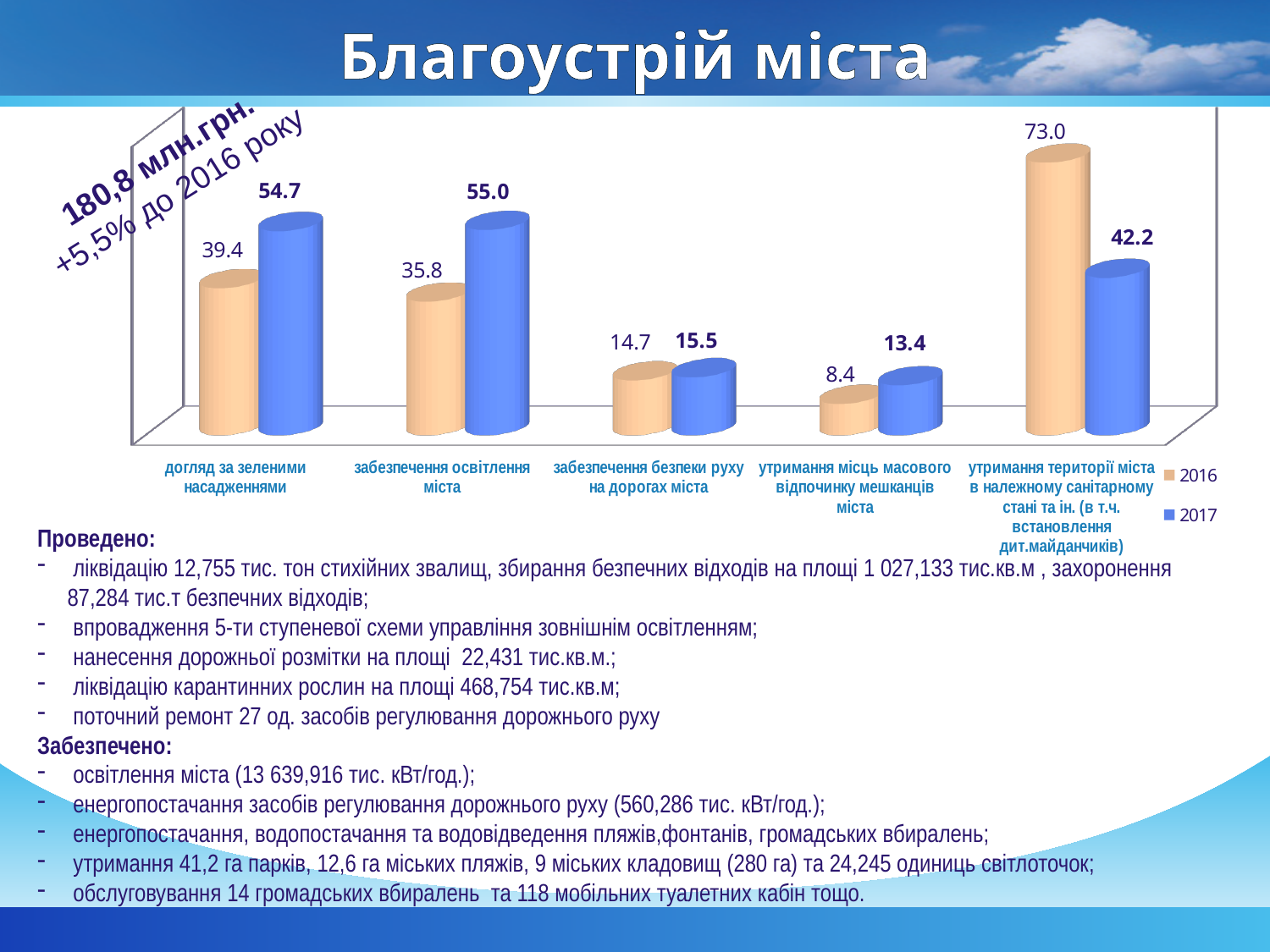
What type of chart is shown on the slide? bar chart What is the 2016 value for "забезпечення освітлення міста"? 35.8 How many series does the chart legend list? 2 What is the difference between the 2016 and 2017 values for "утримання території міста в належному санітарному стані та ін."? 30.8 What is the 2017 value for "догляд за зеленими насадженнями"? 54.7 Which category has the highest 2016 value? утримання території міста в належному санітарному стані та ін. What is the difference between the 2017 and 2016 values for "забезпечення безпеки руху на дорогах міста"? 0.8 How many categories are shown on the x axis of the chart? 5 Which colour represents the 2017 series in the chart? blue Which category has the lowest 2017 value? утримання місць масового відпочинку мешканців міста Which is larger for "забезпечення освітлення міста": the 2016 value or the 2017 value? 2017 What is the 2016 value for "утримання місць масового відпочинку мешканців міста"? 8.4